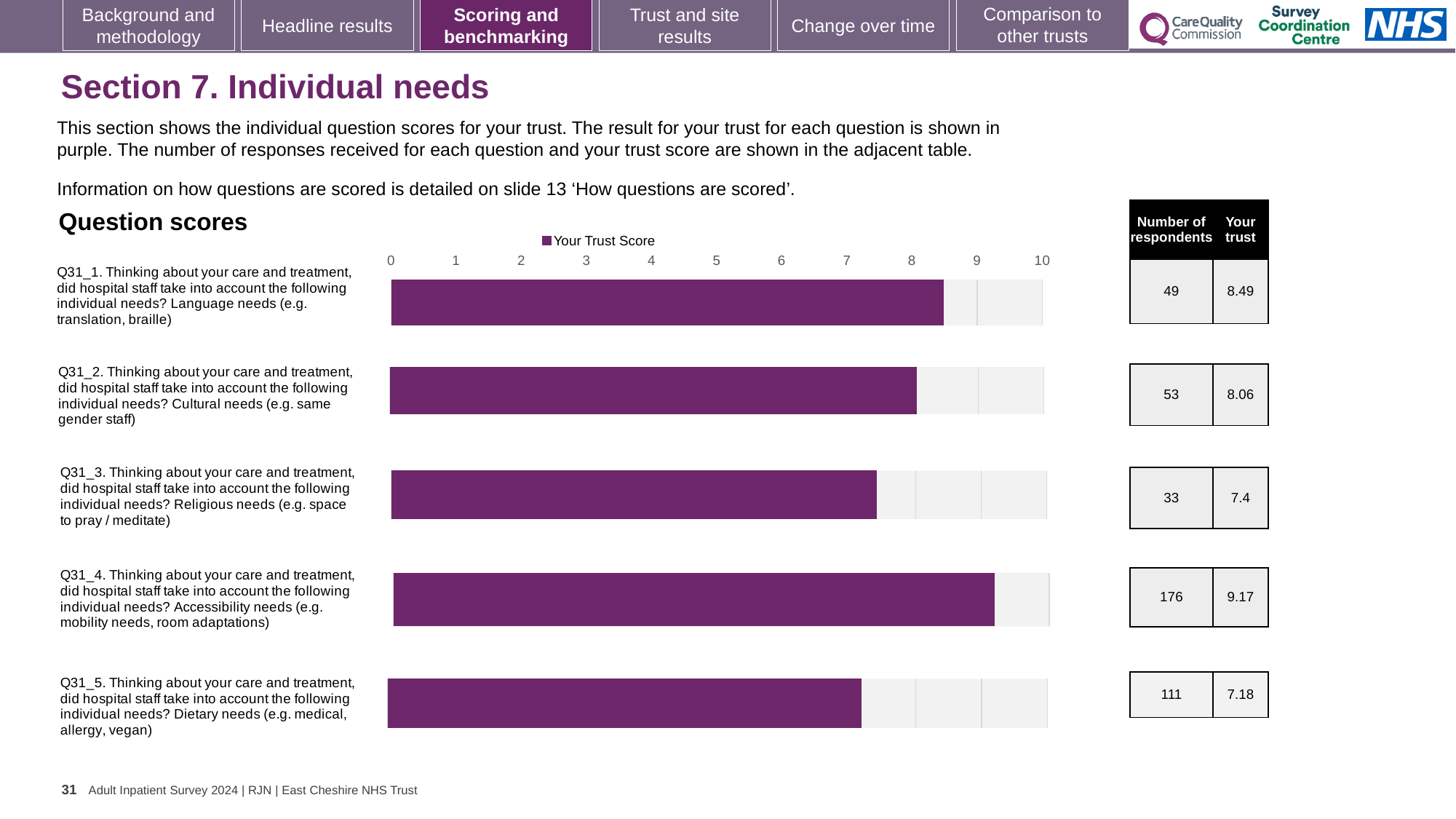
Is the trust score for Q31_3 (Religious needs) greater or less than 8? less Which has a higher trust score, Q31_1 (Language needs) or Q31_2 (Cultural needs)? Q31_1 (Language needs) What type of chart is used to show the question scores? Bar chart What is the trust score for Q31_4 (Accessibility needs)? 9.17 How many questions are plotted in the chart? 5 What series name is shown in the chart legend? Your Trust Score What is the trust score for Q31_5 (Dietary needs)? 7.18 What is the trust score for Q31_1 (Language needs)? 8.49 Which question has the highest trust score? Q31_4 (Accessibility needs) How many respondents answered Q31_3 (Religious needs)? 33 Which question has the lowest trust score? Q31_5 (Dietary needs) What is the difference between the trust scores for Q31_4 and Q31_5? 1.99